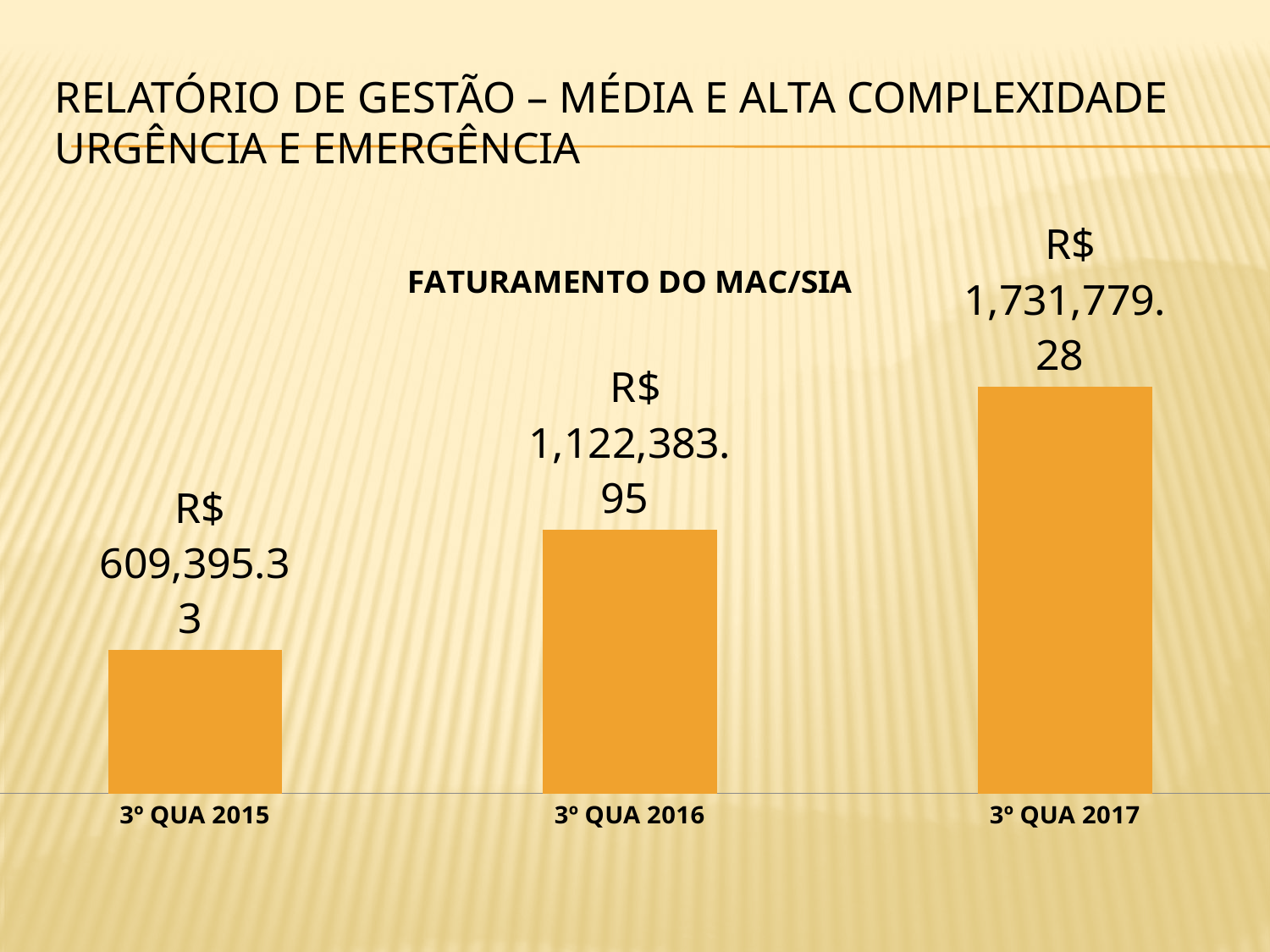
What is the difference between the values for 3º QUA 2017 and 3º QUA 2016? R$ 609,395.33 What kind of chart is shown on the slide? Bar chart Do the values rise or fall from 3º QUA 2015 to 3º QUA 2017? Rise What is the title of the chart on the slide? FATURAMENTO DO MAC/SIA Which category has the highest value in the FATURAMENTO DO MAC/SIA chart? 3º QUA 2017 What is the value for 3º QUA 2016 in the FATURAMENTO DO MAC/SIA chart? R$ 1,122,383.95 Which category has the lowest value in the FATURAMENTO DO MAC/SIA chart? 3º QUA 2015 How many categories are shown in the FATURAMENTO DO MAC/SIA chart? 3 What is the value for 3º QUA 2017 in the FATURAMENTO DO MAC/SIA chart? R$ 1,731,779.28 What is the value for 3º QUA 2015 in the FATURAMENTO DO MAC/SIA chart? R$ 609,395.33 What is the difference between the values for 3º QUA 2016 and 3º QUA 2015? R$ 512,988.62 Which is larger, the value for 3º QUA 2016 or the value for 3º QUA 2015? 3º QUA 2016